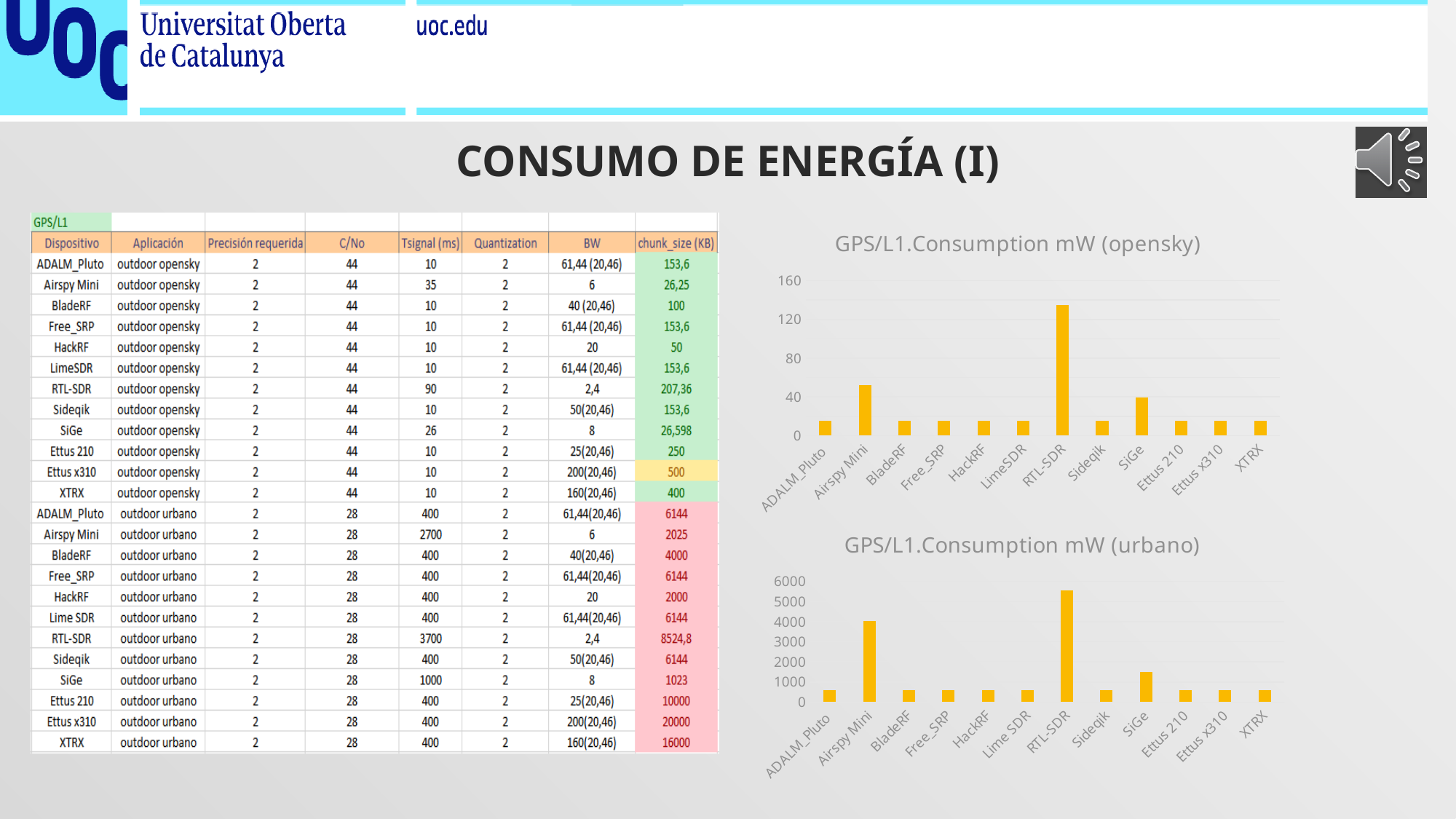
In the 'GPS/L1.Consumption mW (opensky)' chart, is the value for HackRF greater or less than 40? less How many devices are shown on the x axis of the 'GPS/L1.Consumption mW (opensky)' chart? 12 What is the title of the lower chart on the slide? GPS/L1.Consumption mW (urbano) In the 'GPS/L1.Consumption mW (opensky)' chart, is the value for RTL-SDR greater or less than 120? greater In the 'GPS/L1.Consumption mW (urbano)' chart, which device has the highest consumption? RTL-SDR In the 'GPS/L1.Consumption mW (urbano)' chart, is the value for Airspy Mini greater or less than 3000? greater In the 'GPS/L1.Consumption mW (urbano)' chart, which is larger, the value for SiGe or the value for XTRX? SiGe In the 'GPS/L1.Consumption mW (opensky)' chart, which device has the highest consumption? RTL-SDR What type of chart is the 'GPS/L1.Consumption mW (opensky)' chart? bar chart In the 'GPS/L1.Consumption mW (opensky)' chart, which is larger, the value for Airspy Mini or the value for SiGe? Airspy Mini